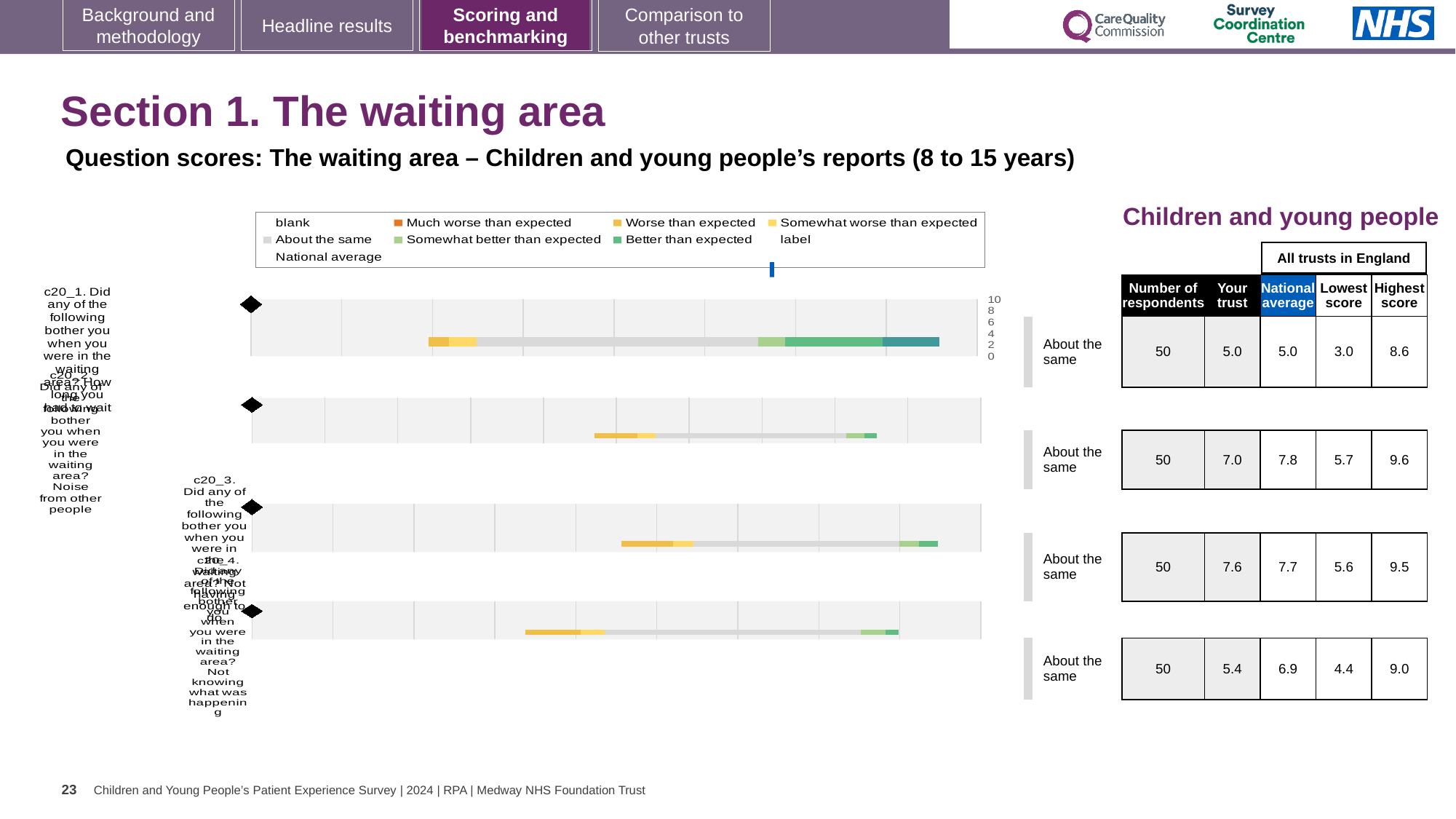
For question c20_2, which is larger: the 'Your trust' score or the national average? National average For question c20_4, what is the difference between the national average and the 'Your trust' score? 1.5 How many question bars are plotted in the chart? 4 What is the national average score for question c20_2 (how long you had to wait)? 7.8 Which question has the highest 'Your trust' score? c20_3 What is the heading printed above the table to the right of the chart? Children and young people How many entries does the chart legend list? 9 What colour represents 'Much worse than expected' in the chart legend? Orange What kind of chart is used to show the question scores for the waiting area? Bar chart What is the 'Your trust' score for question c20_1 (noise from other people)? 5.0 What is the highest score across all trusts in England for question c20_2? 9.6 Which question has the lowest 'Your trust' score? c20_1